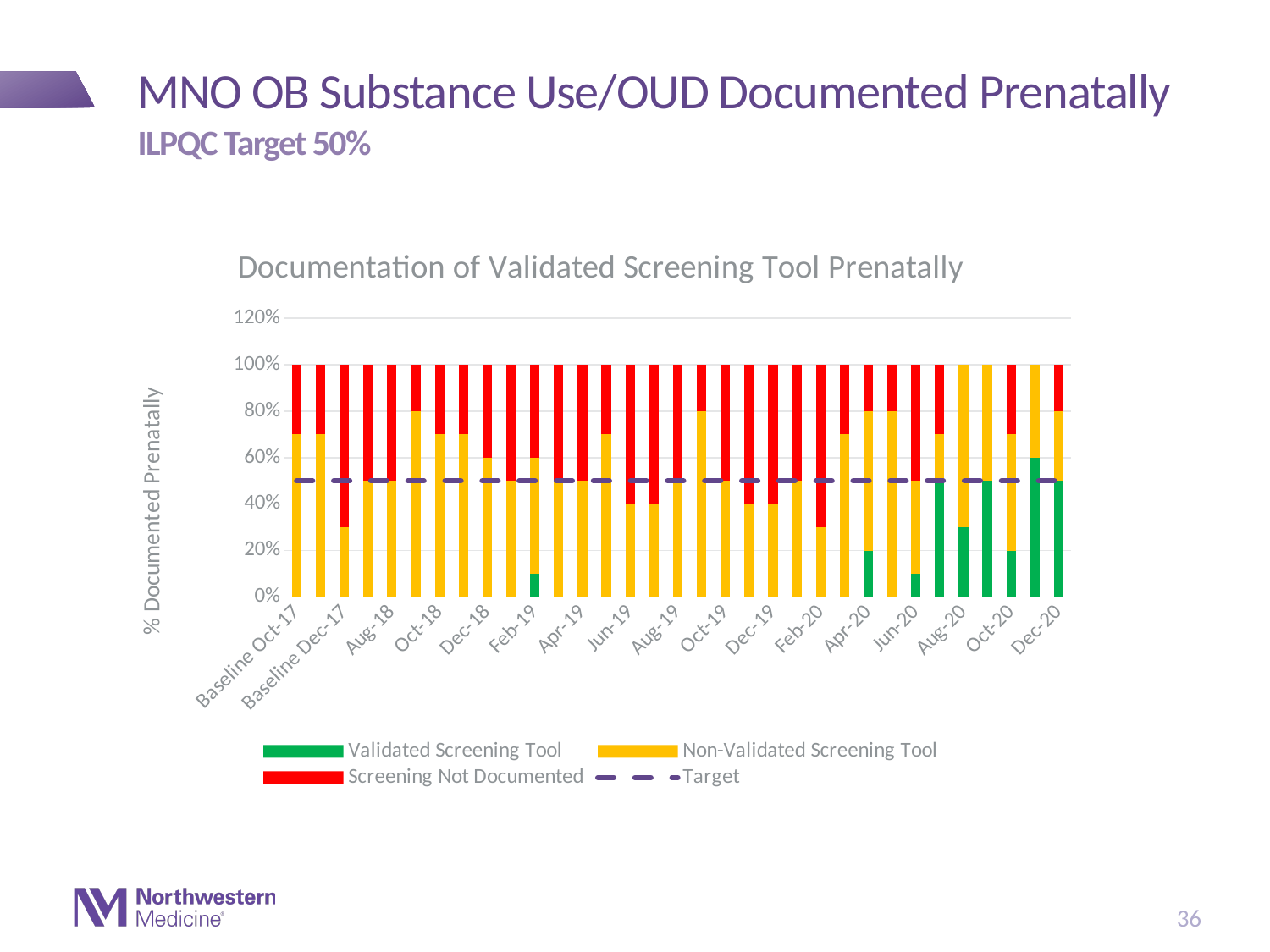
Is the Validated Screening Tool value for Dec-20 greater or less than 40%? greater What kind of chart is shown on the slide? Stacked bar chart What value does the dashed Target line sit at on the chart? 50% Which is larger, the Validated Screening Tool value for Dec-20 or for Baseline Oct-17? Dec-20 What is the title of the chart? Documentation of Validated Screening Tool Prenatally How many date labels are shown along the x axis of the chart? 17 How many entries does the chart legend list? 4 Is the Validated Screening Tool value for Feb-19 greater or less than 20%? less Is the Validated Screening Tool value for Aug-20 greater or less than 20%? greater Which colour represents the Validated Screening Tool series in the chart? Green Does the Validated Screening Tool share generally rise or fall from the 2017 baseline to Dec-20? Rise